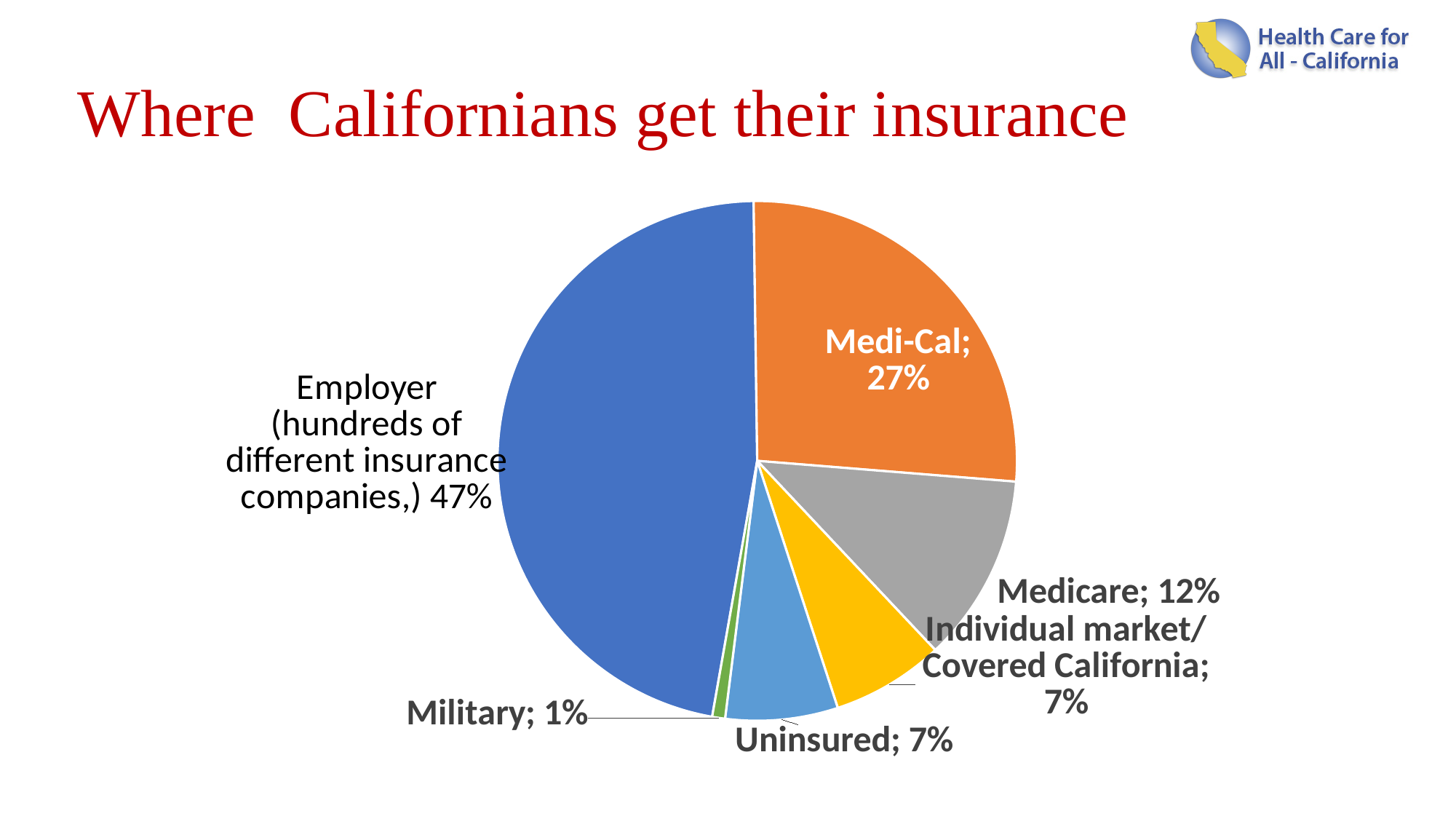
What share is shown for Individual market/Covered California? 7% What percentage of Californians are uninsured according to the chart? 7% What share of Californians get their insurance through Medi-Cal? 27% How many slices does the pie chart have? 6 Which category has the smallest share of the pie? Military What percentage is shown for Military? 1% What share does Medicare account for? 12% Which is larger, the Medicare share or the Uninsured share? Medicare What is the title of the slide containing the chart? Where Californians get their insurance Which category has the largest share of the pie? Employer What is the difference in percentage points between the Employer share and the Medi-Cal share? 20 What kind of chart is shown on the slide? pie chart